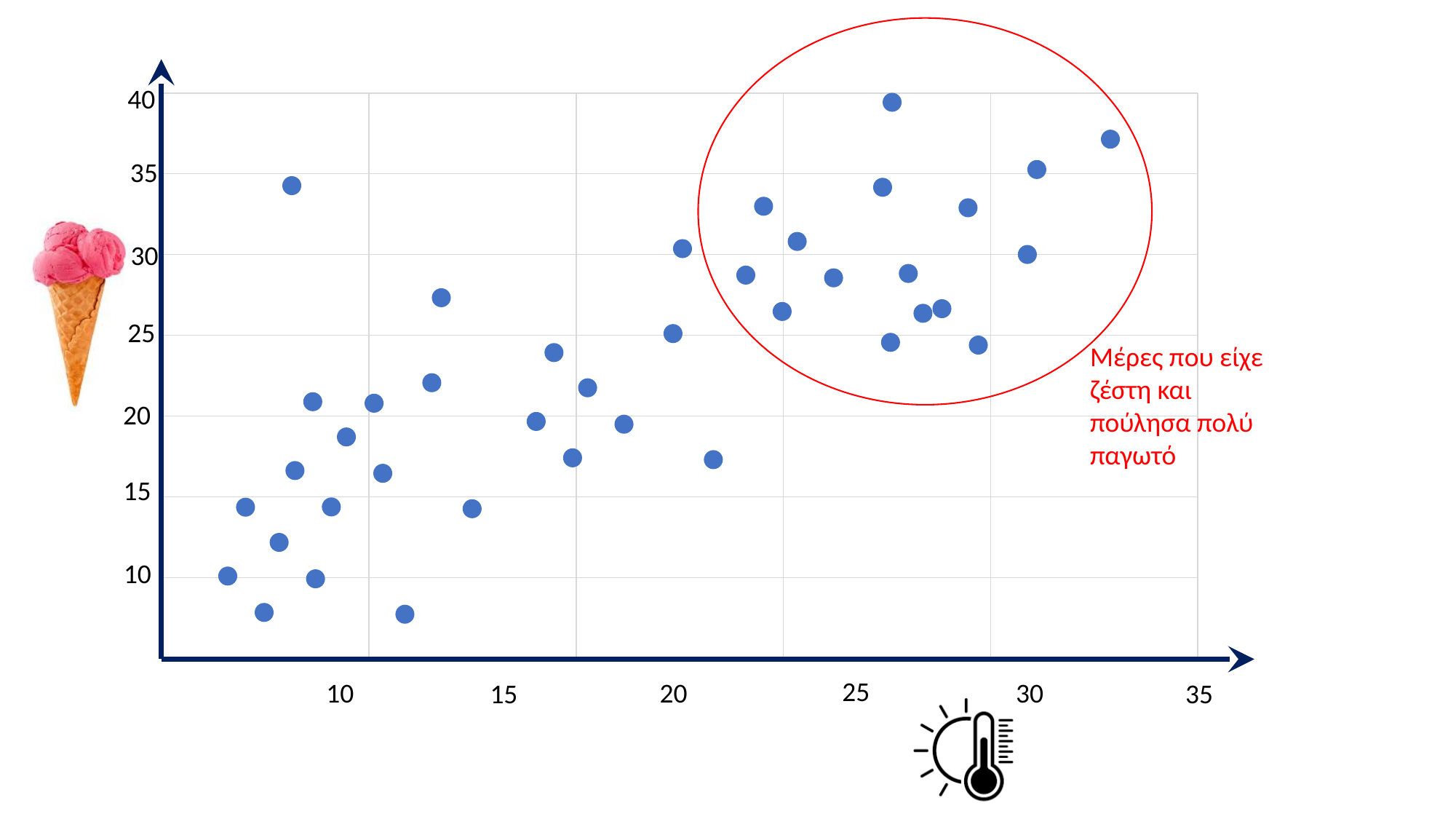
Is the y value of the highest point on the chart greater or less than 35? greater As the x-axis values increase, do the plotted y values generally rise or fall? Rise What kind of chart is shown on the slide? Scatter plot What colour are the plotted points? Blue Is the x value of the rightmost point on the chart greater or less than 30? greater Is the y value of the lowest point on the chart greater or less than 10? less What is the highest value labelled on the y axis? 40